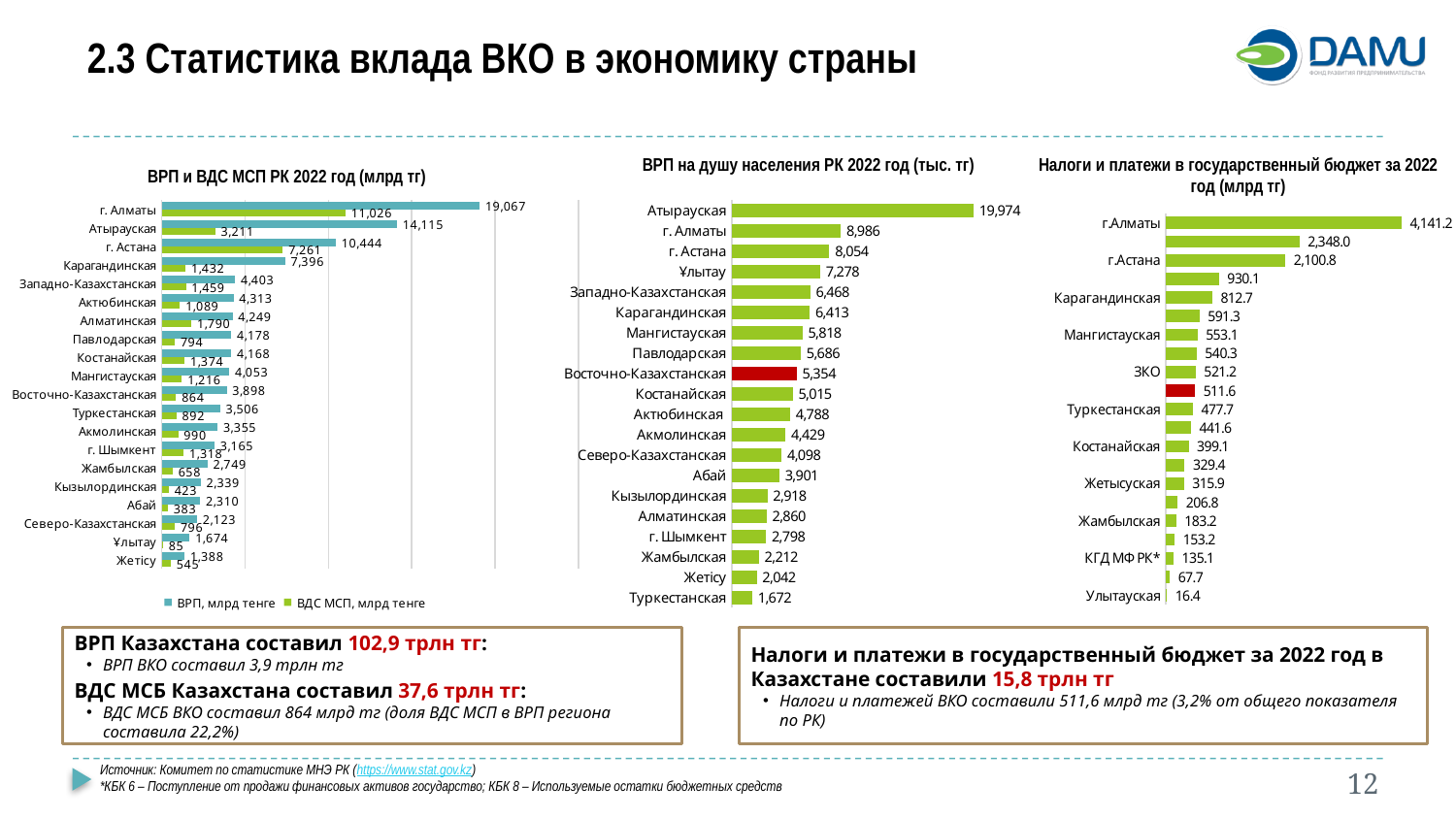
In the chart 'ВРП на душу населения РК 2022 год (тыс. тг)', how many regions are shown? 20 In the chart 'ВРП и ВДС МСП РК 2022 год (млрд тг)', how many series does the legend list? 2 In the chart 'ВРП на душу населения РК 2022 год (тыс. тг)', what is the value for Восточно-Казахстанская? 5,354 In the chart 'ВРП на душу населения РК 2022 год (тыс. тг)', which region has the highest value? Атырауская In the chart 'Налоги и платежи в государственный бюджет за 2022 год (млрд тг)', what is the value for Улытауская? 16.4 In the chart 'Налоги и платежи в государственный бюджет за 2022 год (млрд тг)', what is the value for г.Алматы? 4,141.2 What type of chart is 'ВРП на душу населения РК 2022 год (тыс. тг)'? Bar chart In the chart 'ВРП и ВДС МСП РК 2022 год (млрд тг)', what is the difference between the ВРП and ВДС МСП values for г. Астана? 3,183 In the chart 'ВРП и ВДС МСП РК 2022 год (млрд тг)', what is the ВРП value for г. Алматы? 19,067 In the chart 'ВРП и ВДС МСП РК 2022 год (млрд тг)', what is the ВДС МСП value for Восточно-Казахстанская? 864 In the chart 'ВРП и ВДС МСП РК 2022 год (млрд тг)', which region has the lowest ВДС МСП value? Ұлытау In the chart 'ВРП на душу населения РК 2022 год (тыс. тг)', which is larger: the value for Ұлытау or the value for Карагандинская? Ұлытау